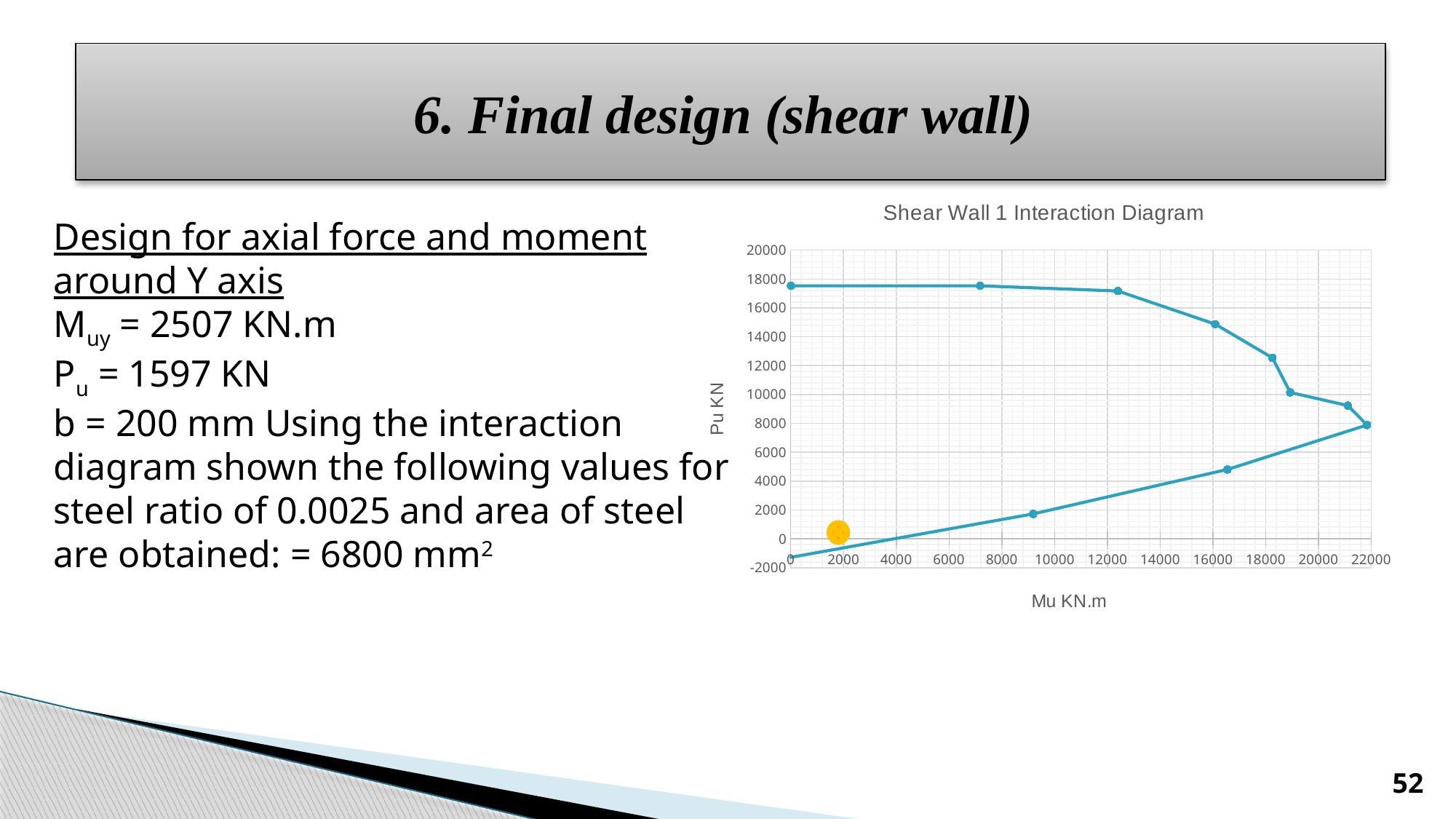
Along the upper branch of the curve, as Mu increases from 0 toward 22000, does Pu rise or fall? fall What kind of chart is the Shear Wall 1 Interaction Diagram? Line chart (XY scatter with lines) What is the highest tick value shown on the vertical (Pu KN) axis? 20000 Is the Pu value of the orange point greater or less than 2000? less Is the Mu value of the orange point greater or less than 4000? less What is the highest tick value shown on the horizontal (Mu KN.m) axis? 22000 Which has the larger Pu value: the point at Mu = 0 on the upper branch or the point at Mu ≈ 22000? The point at Mu = 0 What is the label of the vertical axis of the chart? Pu KN What is the lowest tick value shown on the vertical (Pu KN) axis? -2000 Is the maximum Mu value reached by the interaction curve greater or less than 20000? greater What is the title of the chart on the slide? Shear Wall 1 Interaction Diagram